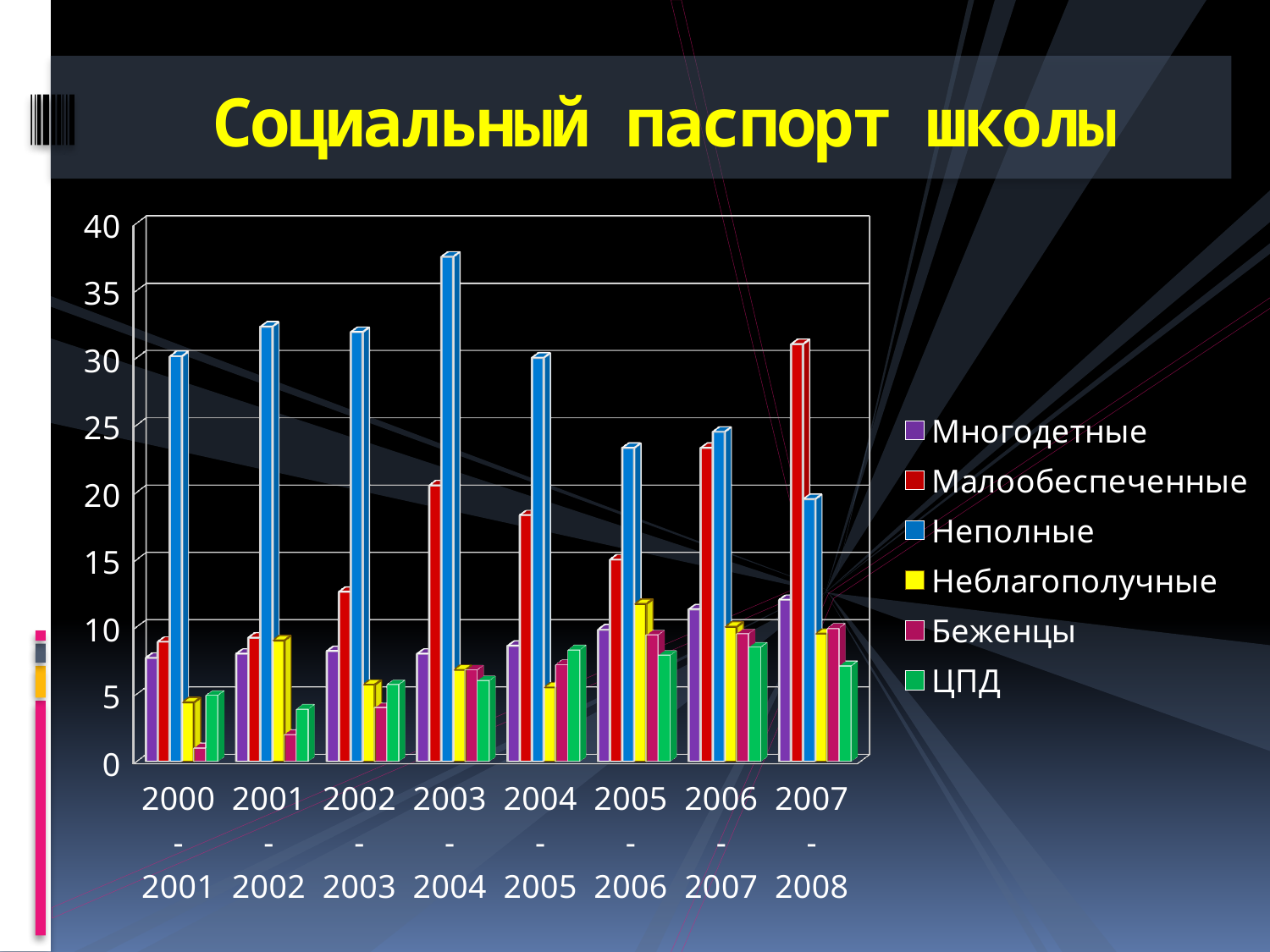
Is the value for Беженцы in 2000-2001 greater or less than 5? less In which period is the value for Неполные the highest? 2003-2004 What kind of chart is shown on the slide? bar chart Is the value for Неполные in 2003-2004 greater or less than 35? greater In 2007-2008, which is larger: Малообеспеченные or Неполные? Малообеспеченные How many series does the legend list? 6 How many year periods are shown on the x axis? 8 Is the value for Малообеспеченные in 2007-2008 greater or less than 30? greater In which period is the value for Малообеспеченные the highest? 2007-2008 What is the title of the chart on the slide? Социальный паспорт школы Does the value for Многодетные generally rise or fall from 2000-2001 to 2007-2008? rise In which period is the value for Беженцы the lowest? 2000-2001